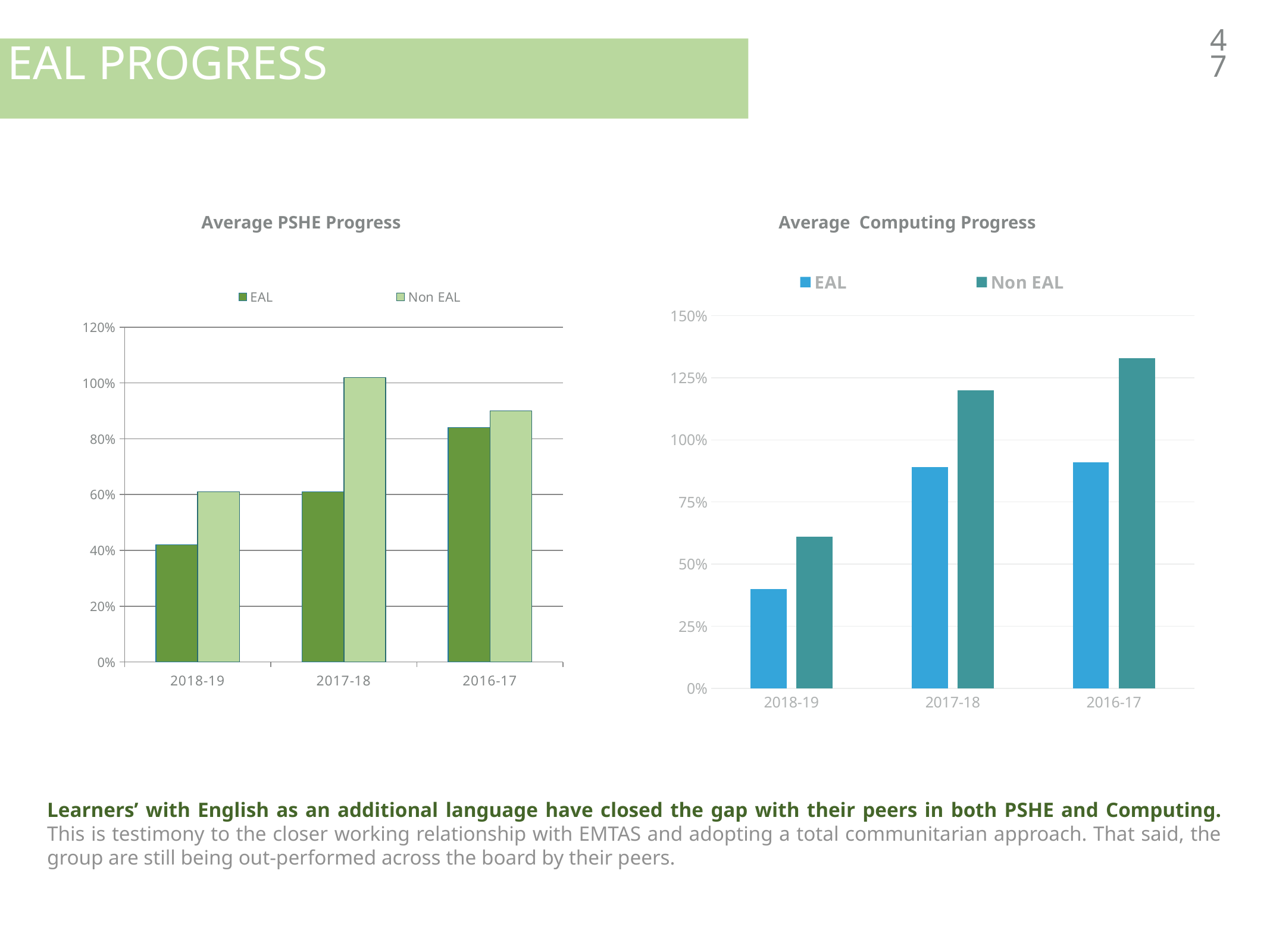
In the Average PSHE Progress chart, which year has the highest EAL value? 2016-17 What type of chart is the Average PSHE Progress chart? bar chart How many year categories are shown on the x axis of the Average PSHE Progress chart? 3 In the Average Computing Progress chart, is the Non EAL value for 2017-18 greater or less than 100%? greater How many series does the legend of the Average Computing Progress chart list? 2 In the Average Computing Progress chart, which year has the highest Non EAL value? 2016-17 In the Average PSHE Progress chart, is the Non EAL value for 2017-18 greater or less than 100%? greater In the Average Computing Progress chart, is the EAL value for 2018-19 greater or less than 50%? less In the Average PSHE Progress chart, which year has the lowest Non EAL value? 2018-19 What are the two legend entries in the Average PSHE Progress chart? EAL and Non EAL In the Average Computing Progress chart, which is larger for 2016-17, EAL or Non EAL? Non EAL